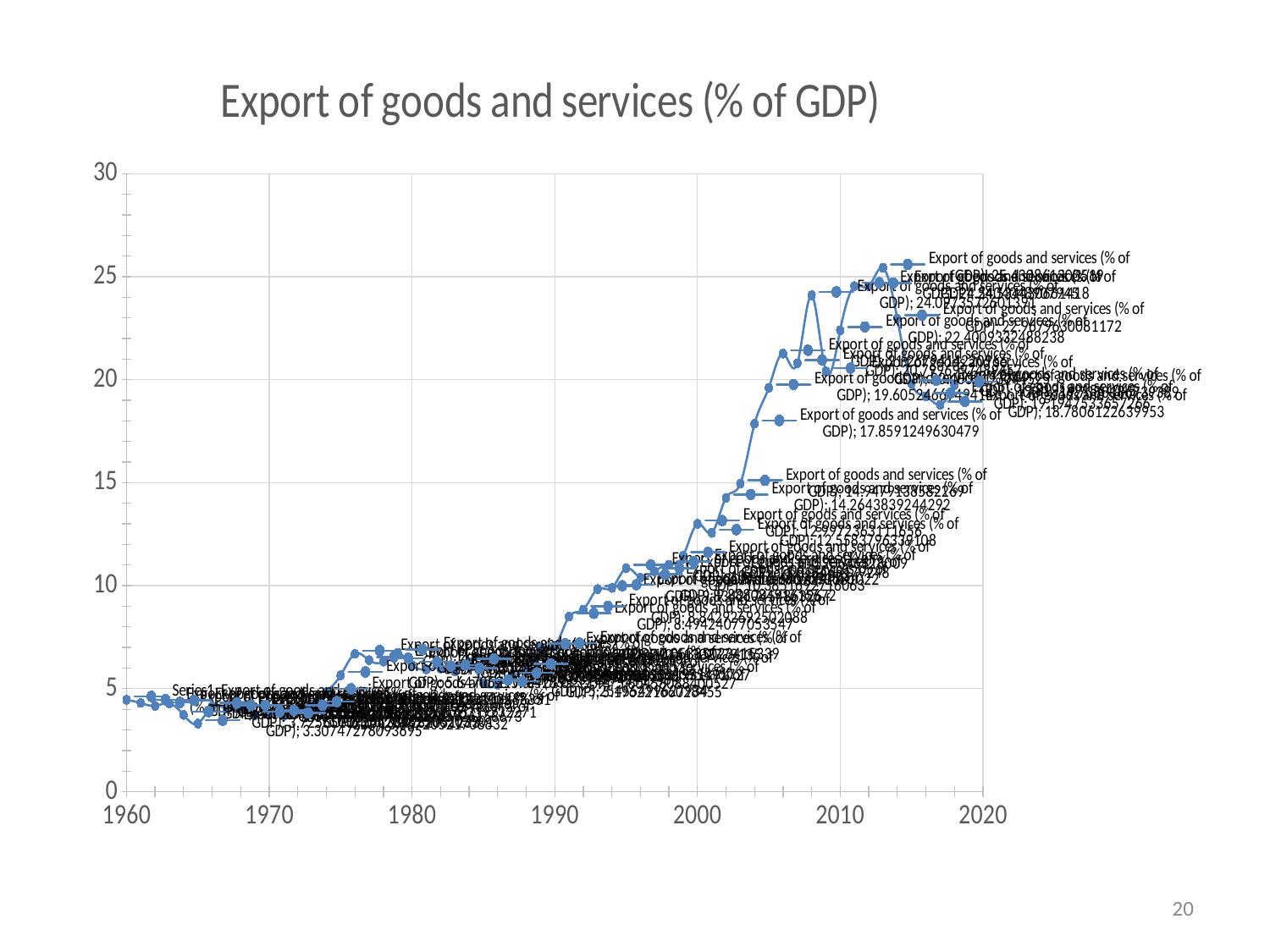
Is the value for 2000 greater or less than 15? less What is the title of the chart? Export of goods and services (% of GDP) Which year has the larger value, 1980 or 1990? 1990 Is the value for 1960 greater or less than 5? less Is the value for 1980 greater or less than 10? less What is the first year shown on the x axis? 1960 Which year has the larger value, 1970 or 2010? 2010 Overall, do the values rise or fall from 1960 to 2020? rise Is the highest value on the chart reached before or after 2010? after What kind of chart is shown on the slide? line chart